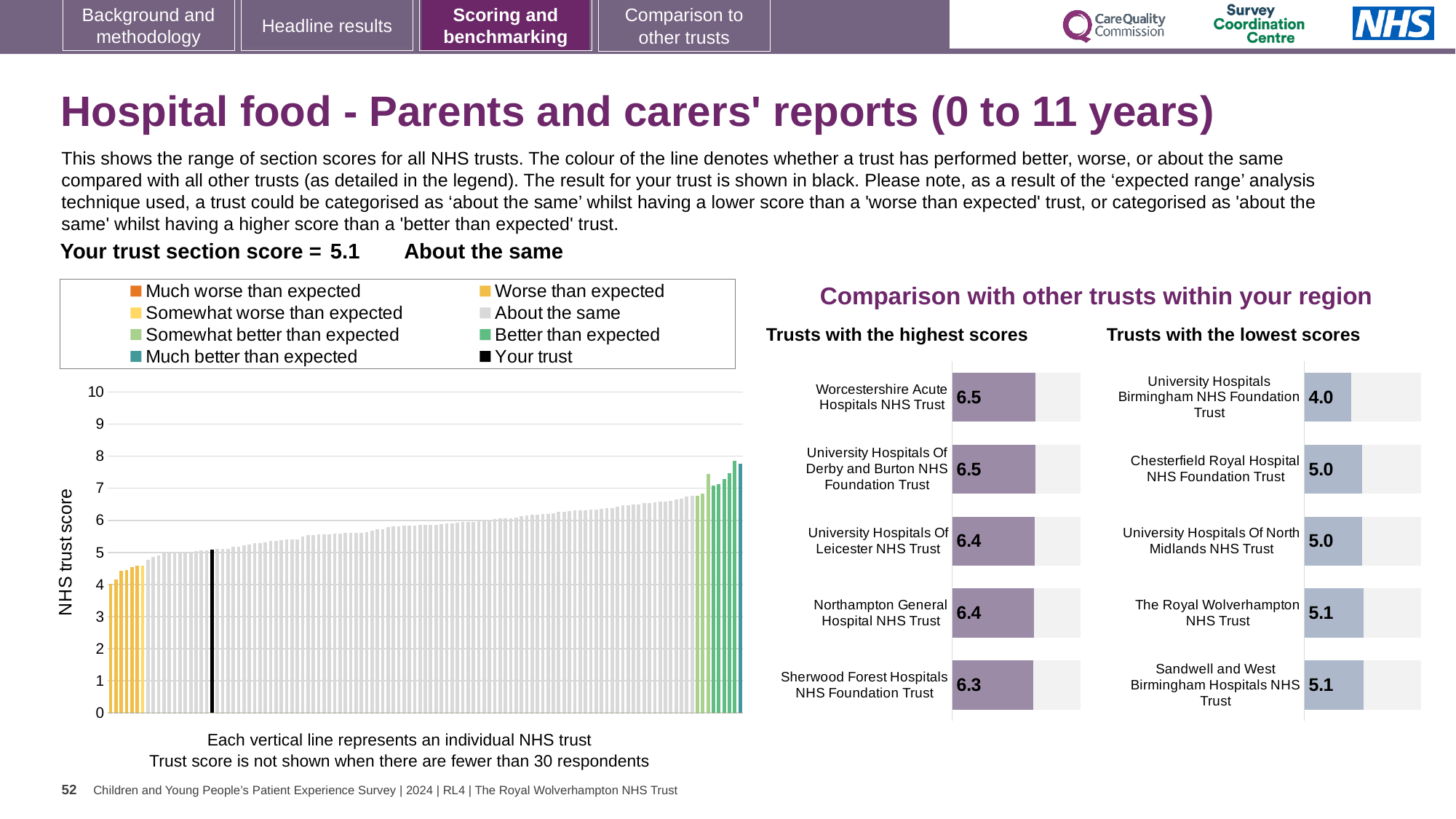
In the 'Trusts with the lowest scores' chart, which trust has the lowest score? University Hospitals Birmingham NHS Foundation Trust What kind of chart is the large chart on the left showing NHS trust scores? Bar chart In the 'Trusts with the highest scores' chart, what is the difference between the scores of Worcestershire Acute Hospitals NHS Trust and Sherwood Forest Hospitals NHS Foundation Trust? 0.2 In the 'Trusts with the lowest scores' chart, what is the score for The Royal Wolverhampton NHS Trust? 5.1 How many trusts are shown in the 'Trusts with the highest scores' chart? 5 In the 'Trusts with the lowest scores' chart, what is the score for University Hospitals Birmingham NHS Foundation Trust? 4.0 In the 'Trusts with the highest scores' chart, what is the score for Worcestershire Acute Hospitals NHS Trust? 6.5 In the large chart on the left showing NHS trust scores, is the value of the tallest bar greater or less than 7? greater In the 'Trusts with the lowest scores' chart, which has the higher score: The Royal Wolverhampton NHS Trust or University Hospitals Birmingham NHS Foundation Trust? The Royal Wolverhampton NHS Trust How many entries does the legend of the large chart on the left list? 8 In the 'Trusts with the highest scores' chart, what is the score for Sherwood Forest Hospitals NHS Foundation Trust? 6.3 In the 'Trusts with the lowest scores' chart, what is the difference between the scores of Chesterfield Royal Hospital NHS Foundation Trust and University Hospitals Birmingham NHS Foundation Trust? 1.0